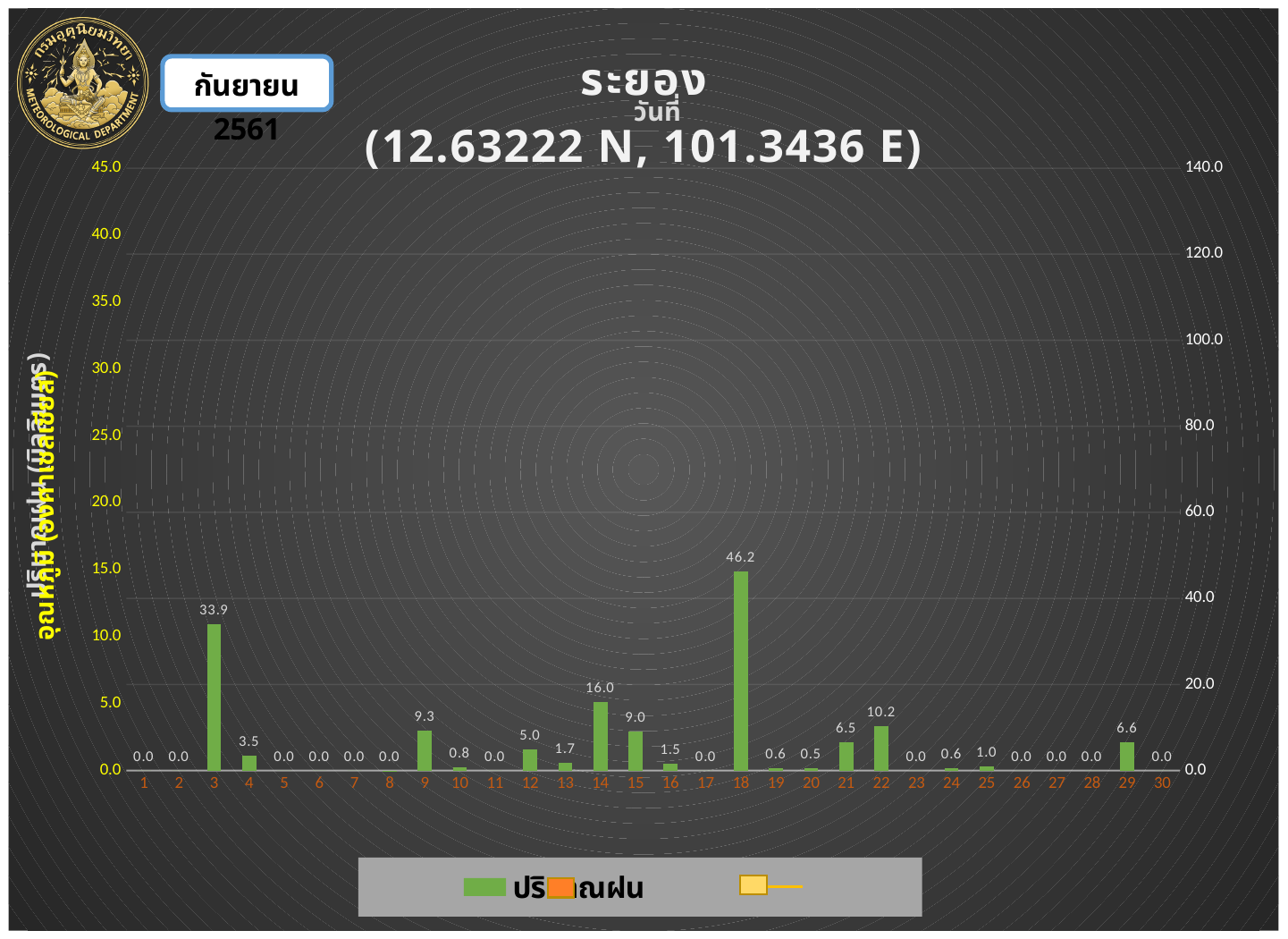
What is the difference between the values for day 18 and day 3? 12.3 Which day has the highest value? 18 What is the value for day 22? 10.2 What is the value for day 3? 33.9 What is the difference between the values for day 14 and day 15? 7.0 What is the value for day 18? 46.2 What kind of chart is shown on the slide? bar chart What is the value for day 14? 16.0 How many days are shown on the x axis? 30 Which is larger, the value for day 9 or the value for day 21? day 9 What is the station name shown in the chart title? ระยอง Which is larger, the value for day 29 or the value for day 12? day 29